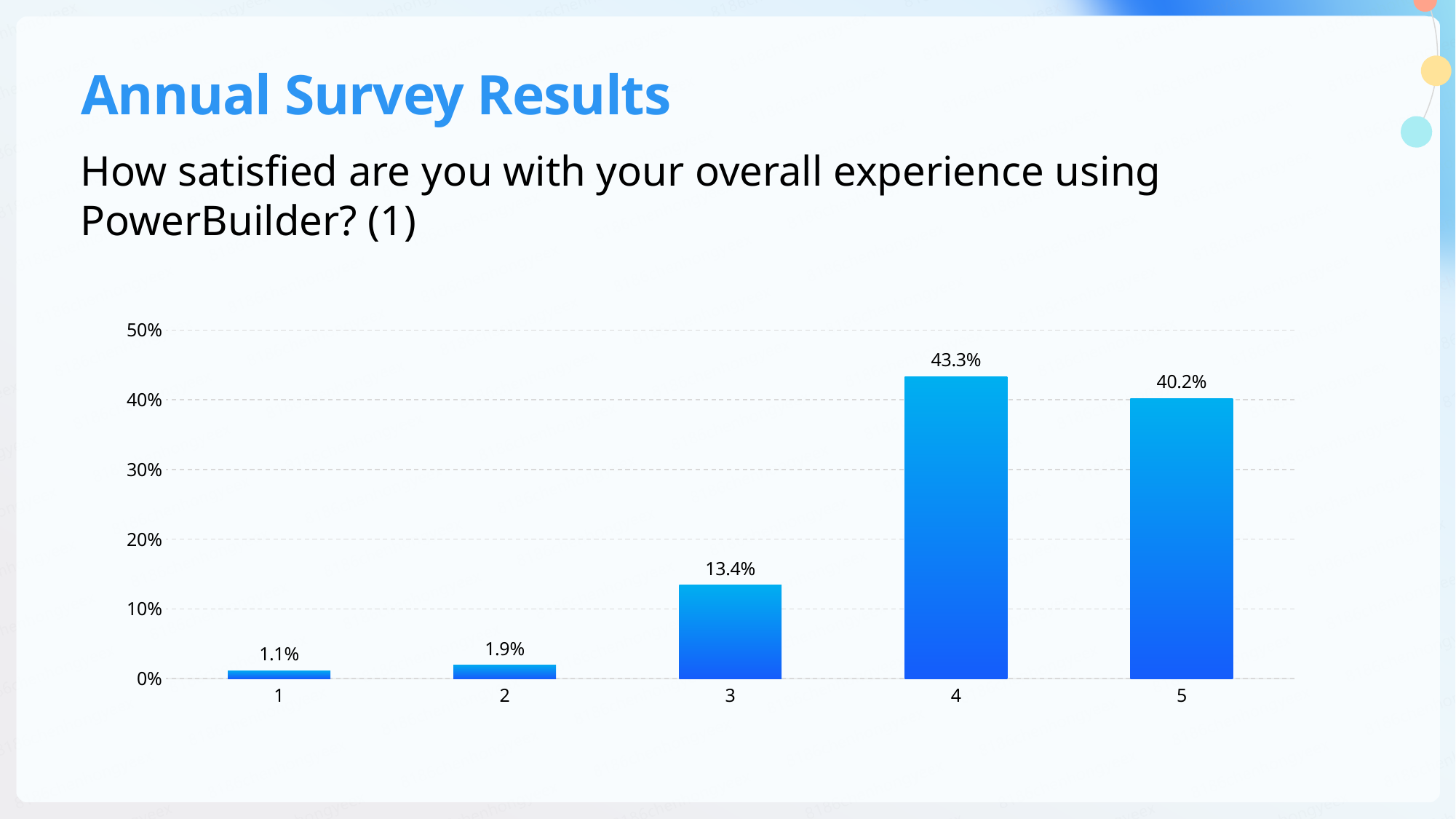
Which has a larger percentage, rating 2 or rating 3? 3 What is the value shown for rating 1? 1.1% What percentage is shown for rating 3? 13.4% What is the highest value labelled on the y axis? 50% What is the difference between the percentages for rating 3 and rating 2? 11.5% What percentage of respondents gave a rating of 4? 43.3% What kind of chart is shown on the slide? bar chart Which rating has the lowest percentage? 1 Which rating has the highest percentage? 4 What is the difference between the percentages for rating 4 and rating 5? 3.1% Is the value for rating 5 greater or less than 30%? greater How many rating categories are shown on the x axis? 5